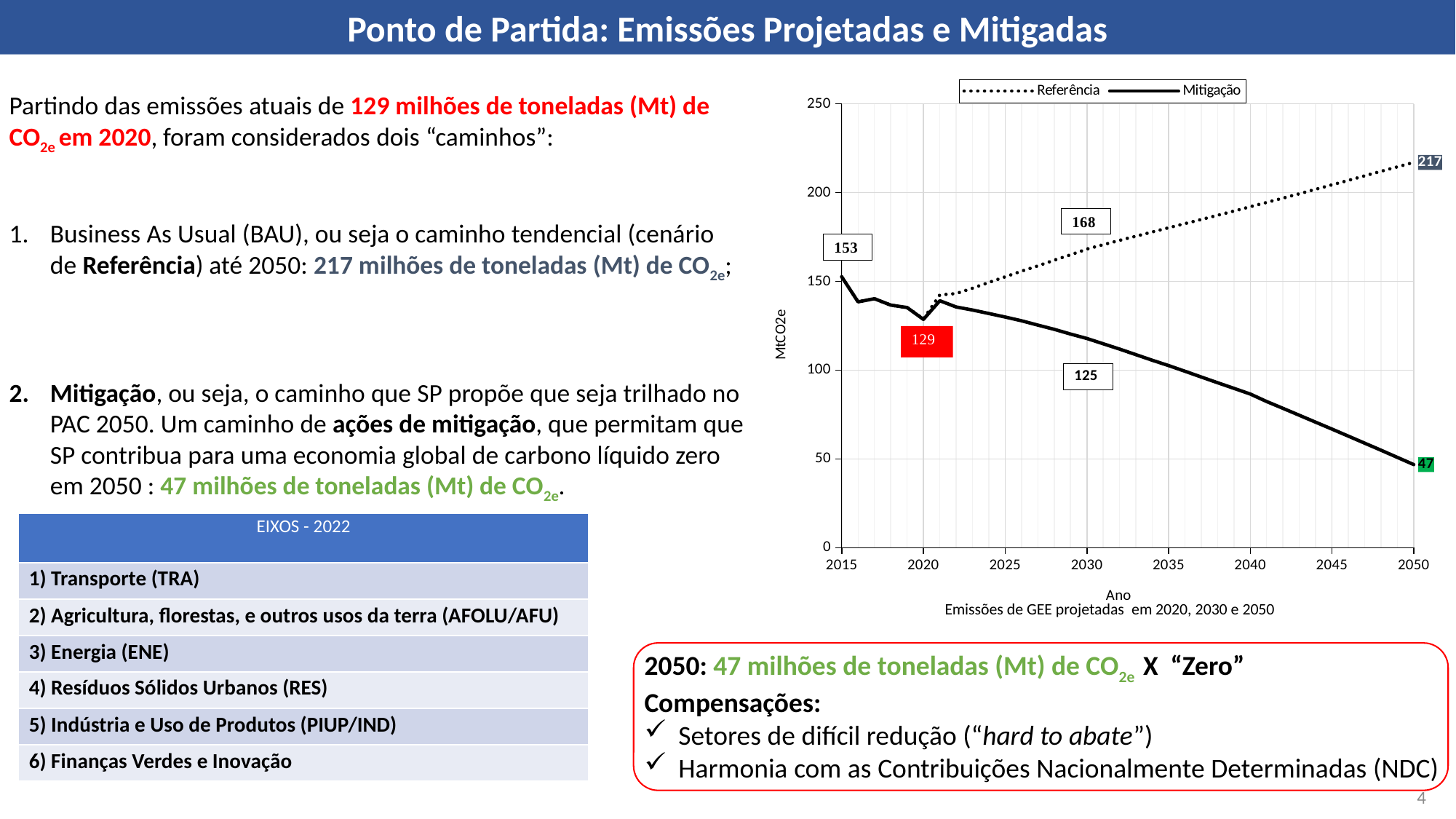
What is the labelled value of the Referência series in 2030? 168 What are the two series named in the chart legend? Referência and Mitigação Does the Mitigação series rise or fall between 2020 and 2050? fall How many series does the chart legend list? 2 What is the labelled emissions value for 2020? 129 What is the labelled value of the Mitigação series in 2050? 47 What is the labelled value of the Referência series in 2050? 217 Which series has the higher value in 2030, Referência or Mitigação? Referência What is the labelled value of the Mitigação series in 2030? 125 What is the difference between the Referência and Mitigação values in 2050? 170 What kind of chart is shown on the slide? line chart What is the label of the y axis of the chart? MtCO2e